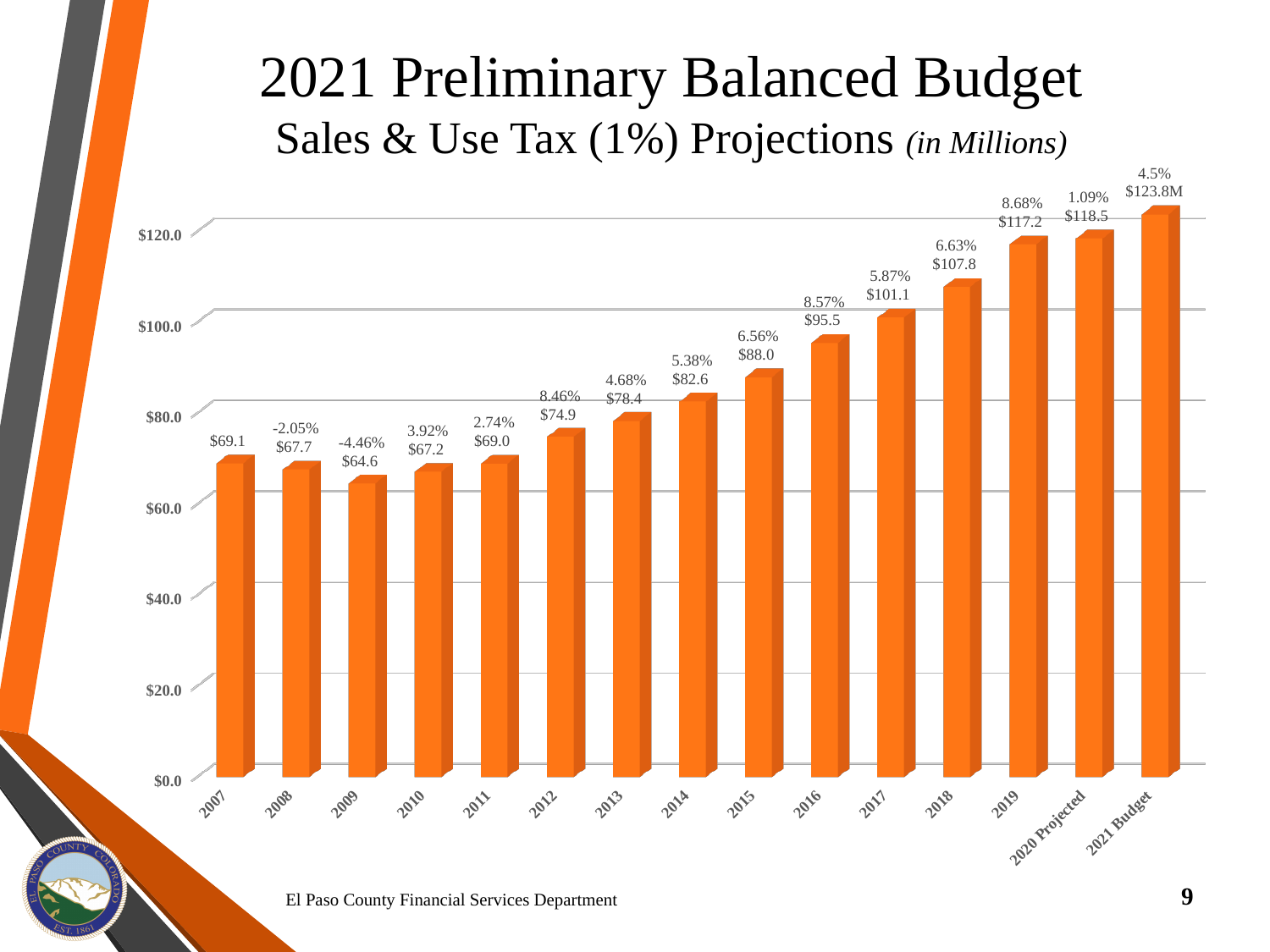
Do the values generally rise or fall from 2010 to 2021 Budget? Rise What is the difference between the 2021 Budget value and the 2020 Projected value? $5.3 What percentage change is shown above the 2019 bar? 8.68% What is the value for 2020 Projected? $118.5 How many bars are shown in the chart? 15 What is the value for 2015? $88.0 What is the difference between the 2019 value and the 2018 value? $9.4 What kind of chart is shown on the slide? Bar chart Which year has the lowest value? 2009 Which category has the highest value? 2021 Budget What percentage change is shown for 2009? -4.46% Which is larger, the value for 2012 or the value for 2013? 2013